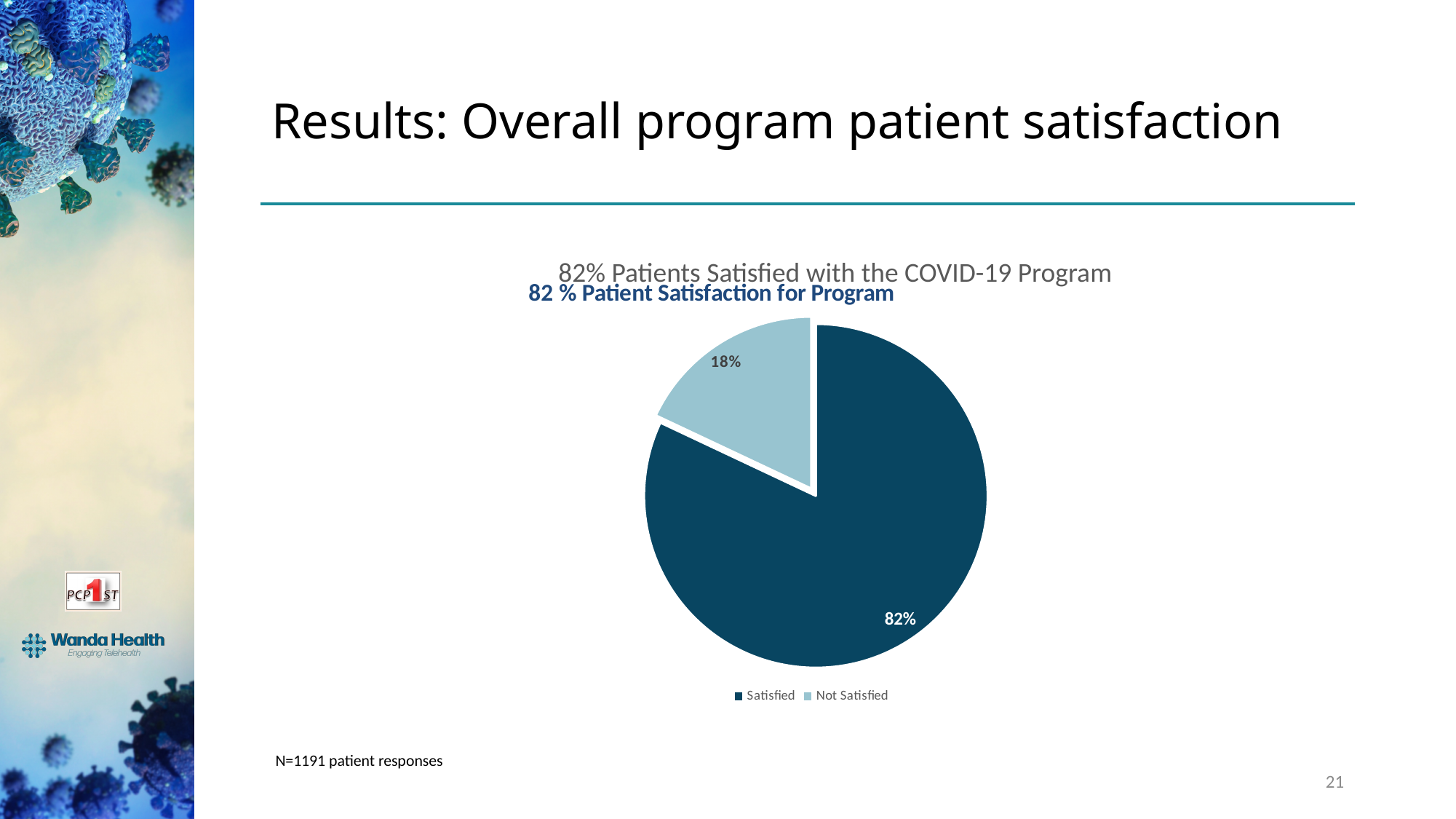
Which slice of the pie chart is the smallest? Not Satisfied Which is larger, the Satisfied slice or the Not Satisfied slice? Satisfied How many slices does the pie chart have? 2 How many patient responses does the note below the chart say the data is based on? N=1191 What percentage of patients were Satisfied according to the pie chart? 82% What share of the pie does the Not Satisfied slice represent? 18% What percentage of patients were Not Satisfied according to the pie chart? 18% What is the difference in percentage points between the Satisfied and Not Satisfied slices? 64 What kind of chart is shown on the slide? pie chart Which slice of the pie chart is the largest? Satisfied How many entries does the legend of the pie chart list? 2